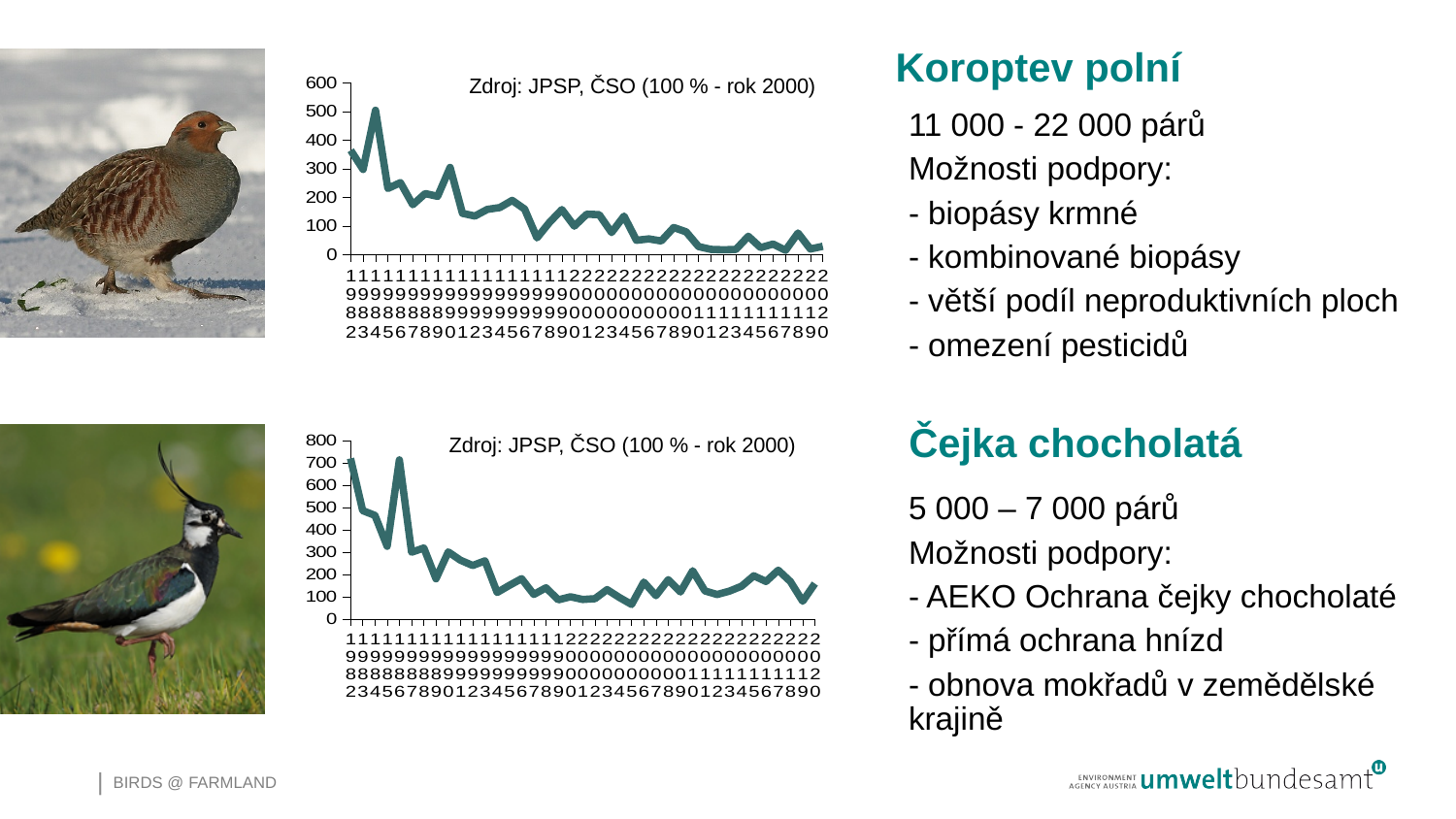
In the bottom chart (Čejka chocholatá), is the value for 2020 greater or less than 300? less In the top chart (Koroptev polní), which is larger: the value for 1982 or the value for 2010? 1982 In the top chart (Koroptev polní), is the value for 1984 greater or less than 400? greater In the top chart (Koroptev polní), which year has the highest value? 1984 What is the highest value shown on the y axis of the bottom chart (Čejka chocholatá)? 800 In the top chart (Koroptev polní), do the values generally rise or fall from 1982 to 2020? fall What title text is shown above the top chart (Koroptev polní)? Zdroj: JPSP, ČSO (100 % - rok 2000) In the bottom chart (Čejka chocholatá), do the values generally rise or fall from 1982 to 2020? fall What kind of chart is the top chart on the slide (next to the partridge, Koroptev polní)? line chart In the bottom chart (Čejka chocholatá), is the value for 1982 greater or less than 600? greater What kind of chart is the bottom chart on the slide (next to the lapwing, Čejka chocholatá)? line chart